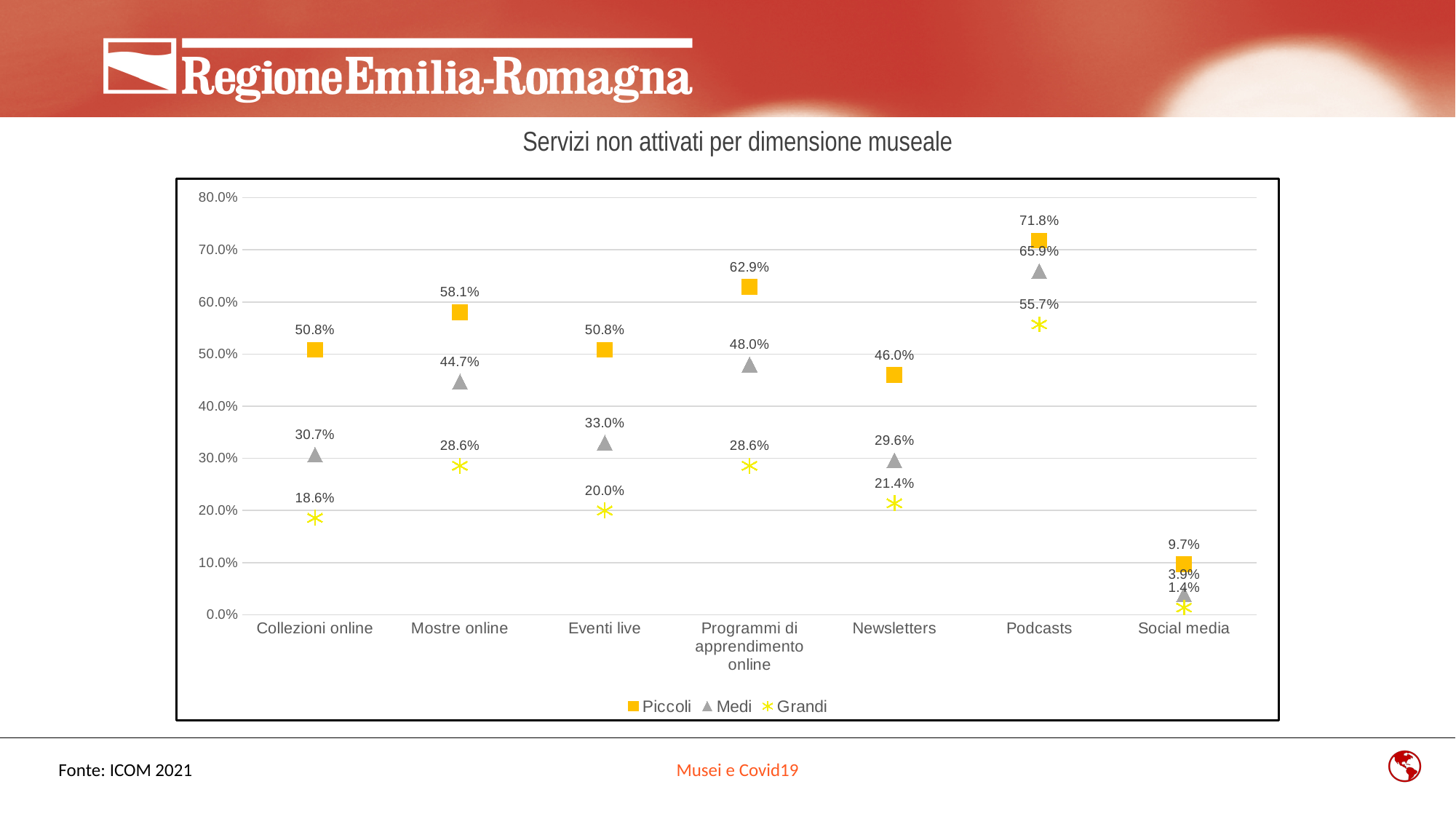
What is the value for Medi at Programmi di apprendimento online? 48.0% How many series does the legend list? 3 What is the difference between the Piccoli and Grandi values at Podcasts? 16.1% Which is larger: the Medi value at Mostre online or the Medi value at Eventi live? Mostre online How many categories are shown on the x axis? 7 What is the difference between the Piccoli values at Mostre online and Newsletters? 12.1% Is the Grandi value at Podcasts greater or less than 50.0%? greater Which category has the highest value for the Piccoli series? Podcasts Which category has the lowest value for the Medi series? Social media What is the value for Grandi at Collezioni online? 18.6% What is the value for Grandi at Social media? 1.4% What is the value for Piccoli at Podcasts? 71.8%